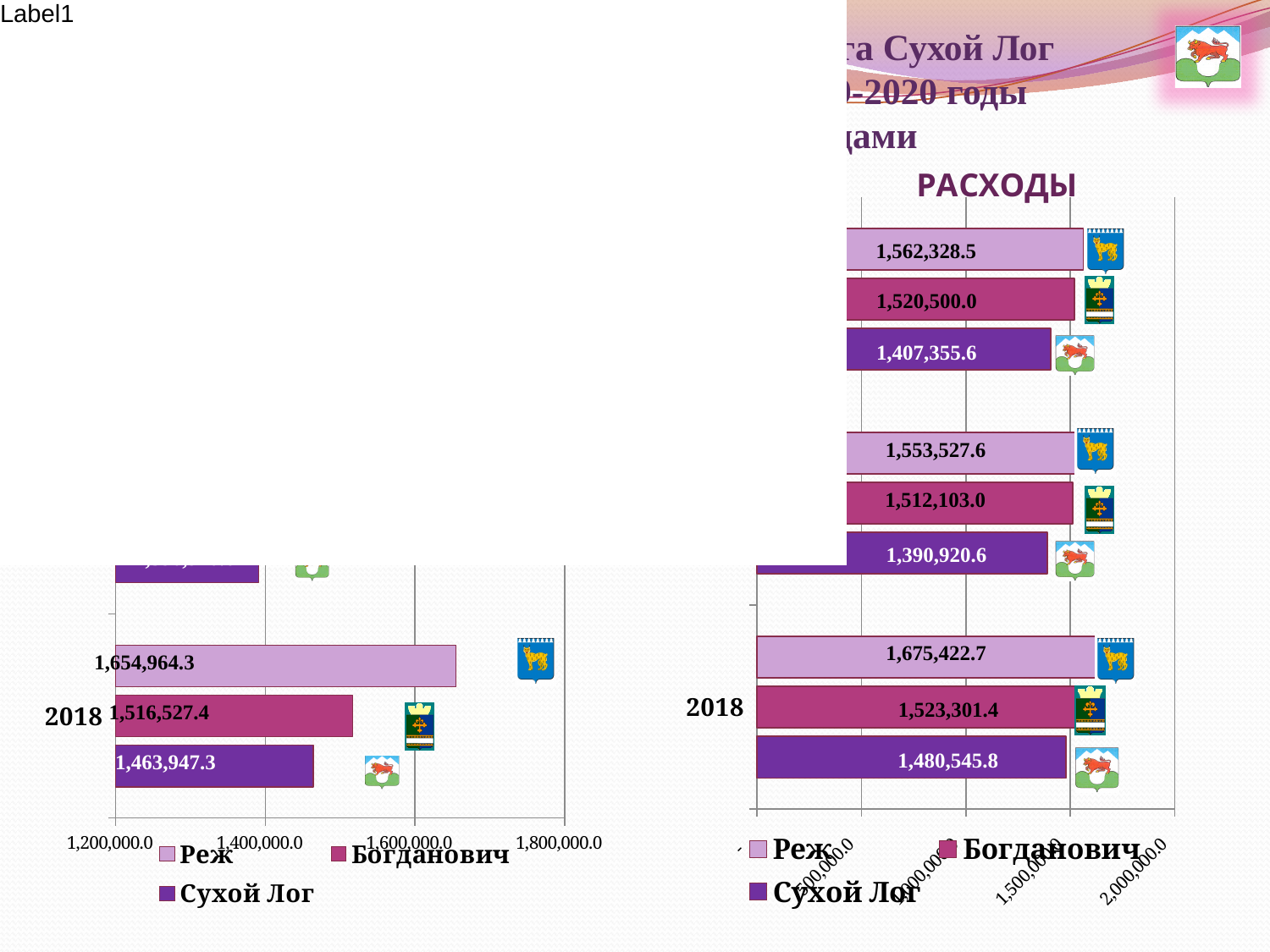
In the chart on the right titled РАСХОДЫ, what is the value for Богданович in 2018? 1,523,301.4 In the chart on the right titled РАСХОДЫ, what is the value for Реж in 2018? 1,675,422.7 In the chart on the right titled РАСХОДЫ, what is the value for Сухой Лог in 2018? 1,480,545.8 How many series does the legend of the chart on the right titled РАСХОДЫ list? 3 In the chart on the left, which series has the lowest value in 2018? Сухой Лог In the chart on the right titled РАСХОДЫ, what is the difference between the 2018 values for Реж and Сухой Лог? 194,876.9 In the chart on the right titled РАСХОДЫ, which series has the highest value in 2018? Реж In the chart on the left, what is the value for Сухой Лог in 2018? 1,463,947.3 In the chart on the left, what is the value for Богданович in 2018? 1,516,527.4 In the chart on the left, what is the value for Реж in 2018? 1,654,964.3 What type of chart is the chart on the right titled РАСХОДЫ? bar chart In the chart on the left, is the 2018 value for Реж greater or less than 1,600,000.0? greater